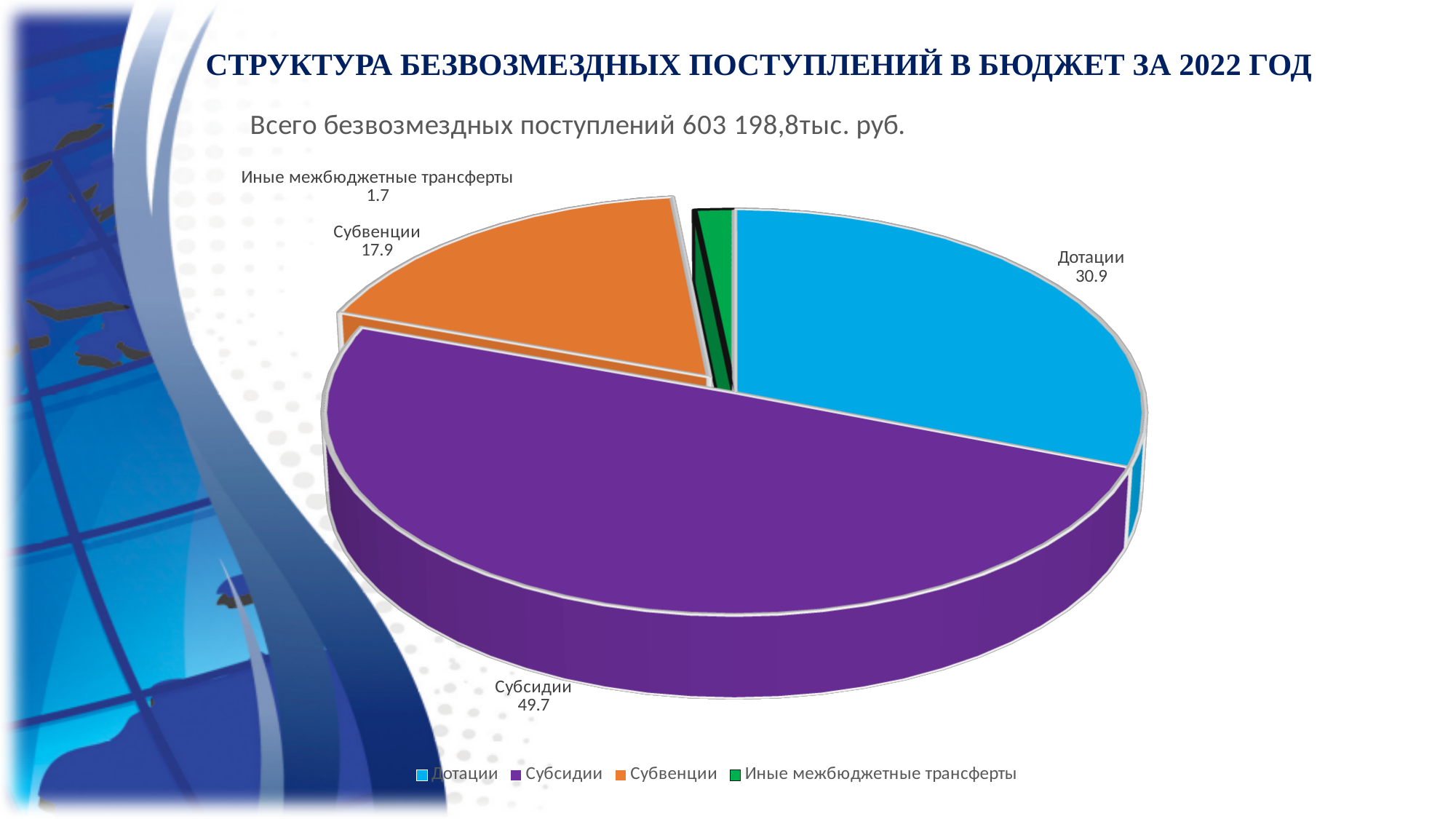
What is the difference between the values for Субсидии and Дотации? 18.8 What is the title of the slide? СТРУКТУРА БЕЗВОЗМЕЗДНЫХ ПОСТУПЛЕНИЙ В БЮДЖЕТ ЗА 2022 ГОД What is the value shown for Иные межбюджетные трансферты? 1.7 What total amount of безвозмездные поступления is stated on the slide? 603 198,8 тыс. руб. What is the value shown for Дотации? 30.9 How many categories are shown in the pie chart? 4 What is the value shown for Субсидии? 49.7 What type of chart is shown on the slide? Pie chart Which category has the largest slice of the pie? Субсидии What is the value shown for Субвенции? 17.9 Which is larger, the value for Дотации or the value for Субвенции? Дотации Which category has the smallest slice of the pie? Иные межбюджетные трансферты